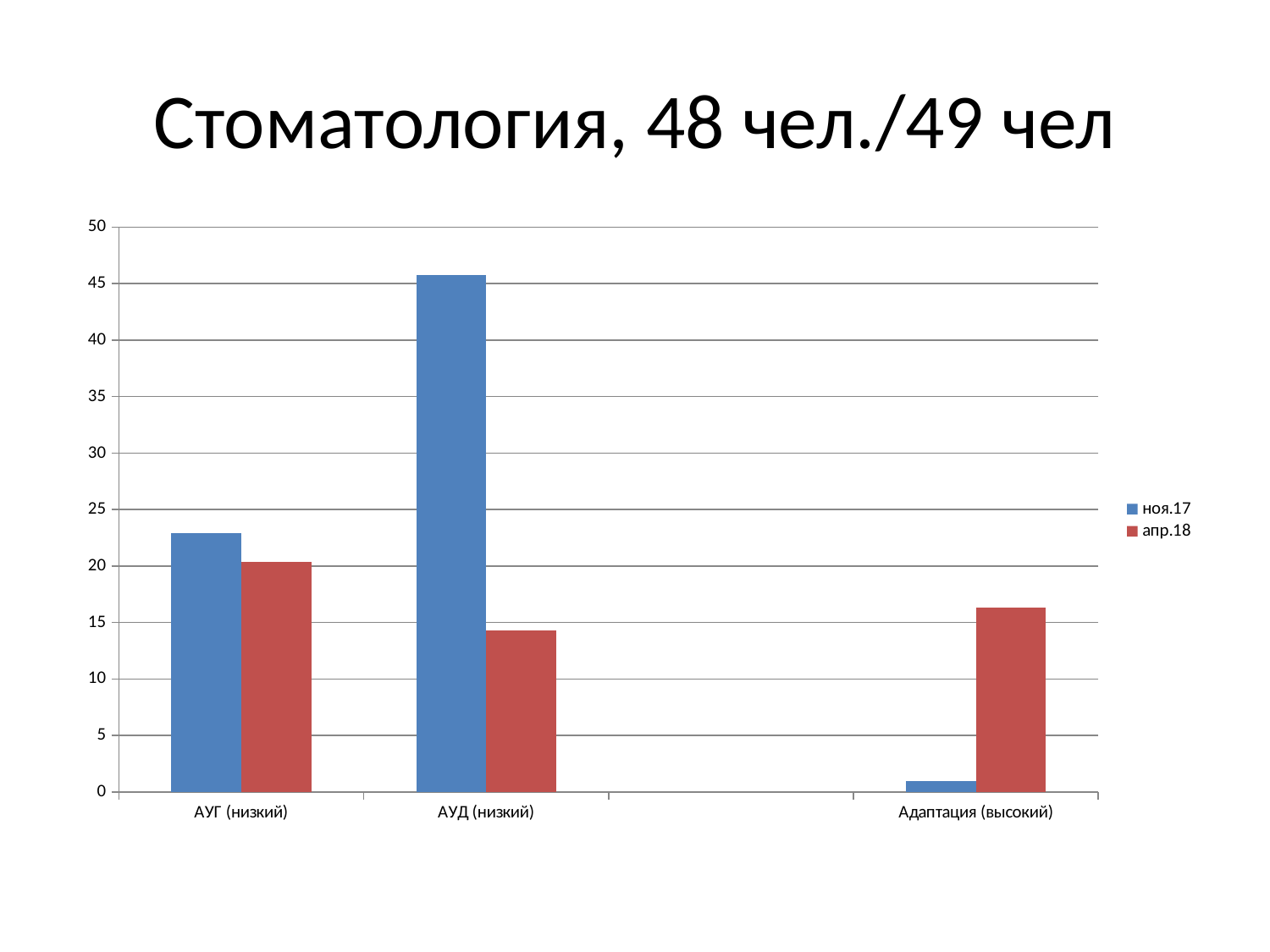
What kind of chart is shown on the slide? bar chart Which category has the lowest value for the апр.18 series? АУД (низкий) For Адаптация (высокий), which series has the larger value, ноя.17 or апр.18? апр.18 How many series does the legend list? 2 What is the title of the slide? Стоматология, 48 чел./49 чел Is the ноя.17 value for АУД (низкий) greater or less than 40? greater Which category has the lowest value for the ноя.17 series? Адаптация (высокий) What are the two series named in the legend? ноя.17 and апр.18 Which category has the highest value for the ноя.17 series? АУД (низкий) How many labelled categories are shown on the x axis? 3 Which category has the highest value for the апр.18 series? АУГ (низкий) For АУД (низкий), which series has the larger value, ноя.17 or апр.18? ноя.17